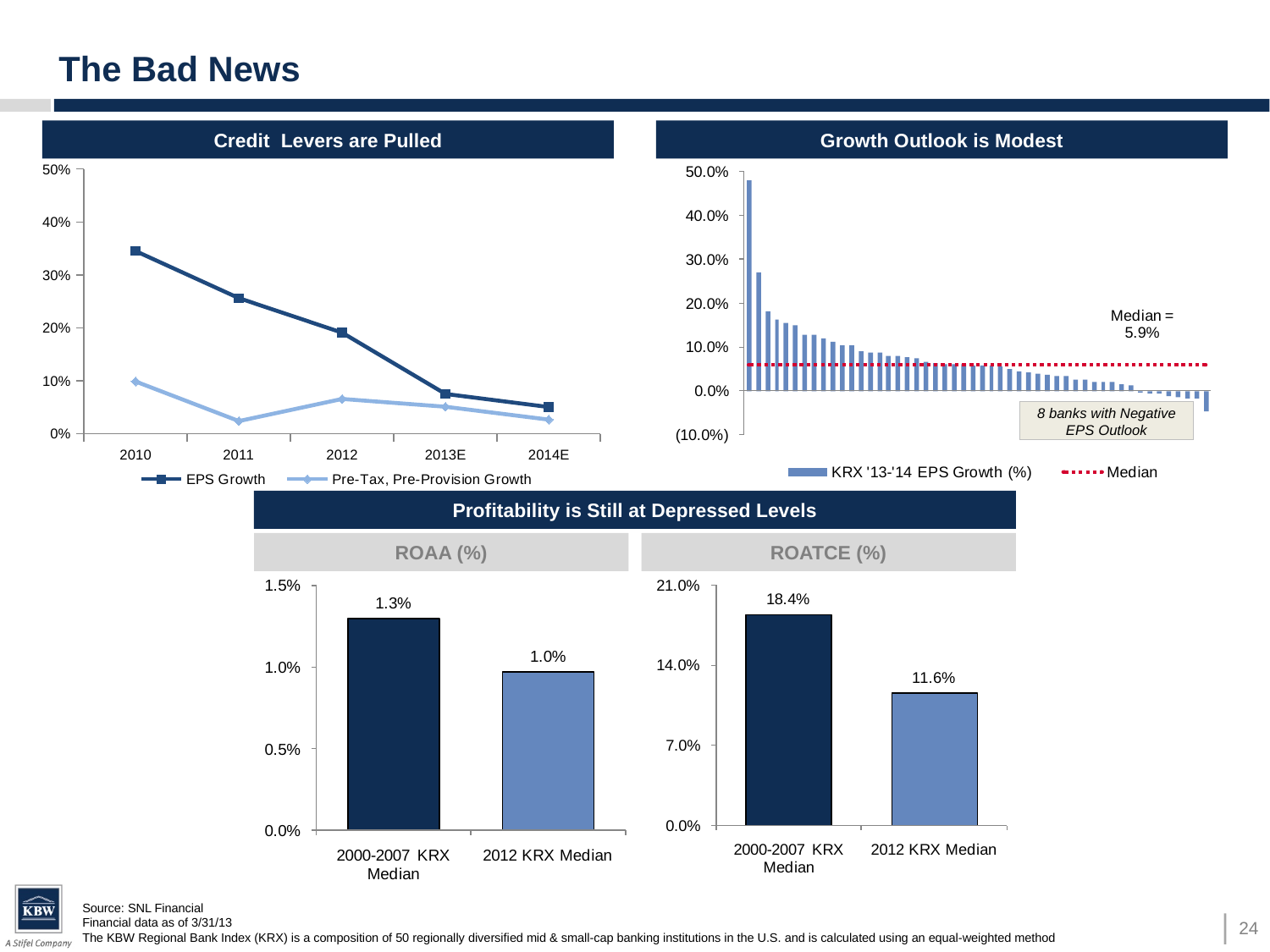
In the 'Growth Outlook is Modest' chart, what is the median KRX '13-'14 EPS growth? 5.9% In the 'Credit Levers are Pulled' chart, how many years are shown on the x axis? 5 In the 'Credit Levers are Pulled' chart, does EPS Growth rise or fall from 2010 to 2014E? fall In the 'Credit Levers are Pulled' chart, is the EPS Growth value for 2010 greater or less than 30%? greater In the 'Credit Levers are Pulled' chart, which series has the higher value in 2011, EPS Growth or Pre-Tax, Pre-Provision Growth? EPS Growth In the 'Credit Levers are Pulled' chart, what kind of chart is shown? line chart In the 'Growth Outlook is Modest' chart, how many banks have a negative EPS outlook according to the annotation? 8 In the ROAA (%) chart, what is the difference between the 2000-2007 KRX Median and the 2012 KRX Median? 0.3% In the ROATCE (%) chart, which category has the highest value? 2000-2007 KRX Median In the ROATCE (%) chart, what is the value for the 2012 KRX Median? 11.6% In the ROAA (%) chart, what is the value for the 2000-2007 KRX Median? 1.3% In the 'Credit Levers are Pulled' chart, how many series does the legend list? 2